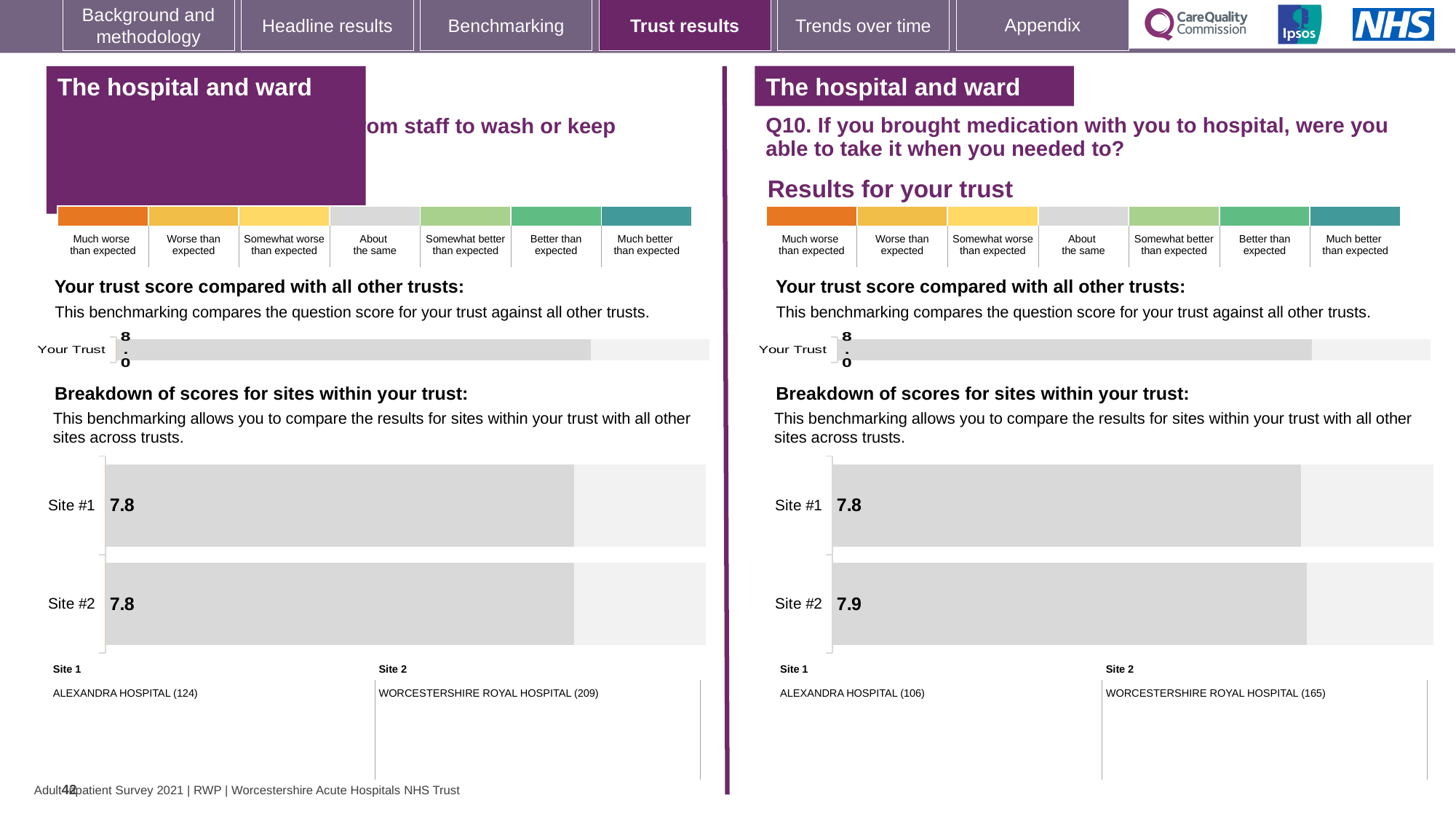
In the right panel (Q10) site breakdown chart, which site has the highest score? Site #2 In the right panel (Q10), what is the score shown for Site #2 in the breakdown of scores for sites within your trust? 7.9 In the right panel (Q10) site breakdown chart, what is the difference between the scores for Site #2 and Site #1? 0.1 In the left panel site breakdown chart, what is the difference between the scores for Site #1 and Site #2? 0 In the right panel (Q10), what is the score shown for Site #1 in the breakdown of scores for sites within your trust? 7.8 What type of chart is used in the right panel (Q10) to show the breakdown of scores for sites within your trust? Bar chart In the right panel (Q10) site breakdown chart, which site has the higher score, Site #1 or Site #2? Site #2 In the right panel (Q10), what is the score shown for Your Trust in the chart comparing your trust score with all other trusts? 8.0 In the left panel, what is the score shown for Your Trust in the chart comparing your trust score with all other trusts? 8.0 In the left panel, what is the score shown for Site #1 in the breakdown of scores for sites within your trust? 7.8 How many sites are shown in the right panel (Q10) breakdown of scores for sites within your trust chart? 2 In the left panel, what is the score shown for Site #2 in the breakdown of scores for sites within your trust? 7.8